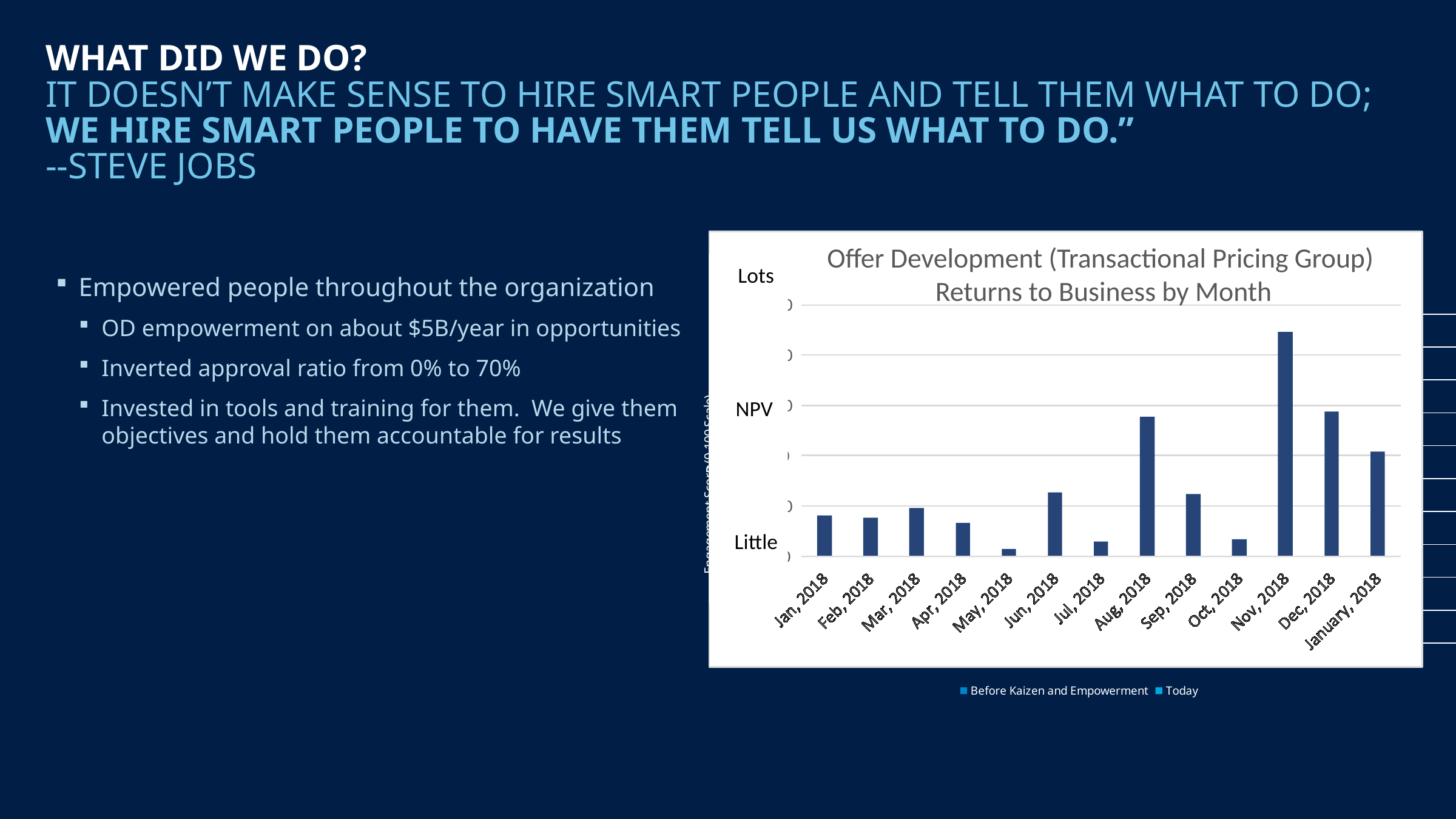
Which month has the highest bar in the chart? Nov, 2018 How many series does the chart legend list? 2 Which bar is taller in the chart: Nov, 2018 or Aug, 2018? Nov, 2018 What are the two series named in the chart legend? Before Kaizen and Empowerment; Today Which bar is taller in the chart: Dec, 2018 or Jan, 2018? Dec, 2018 Which bar is taller in the chart: Jun, 2018 or Jul, 2018? Jun, 2018 Which month has the lowest bar in the chart? May, 2018 What is the title of the chart? Offer Development (Transactional Pricing Group) Returns to Business by Month What kind of chart is shown on the slide? Bar chart How many months (categories) are shown along the x axis of the chart? 13